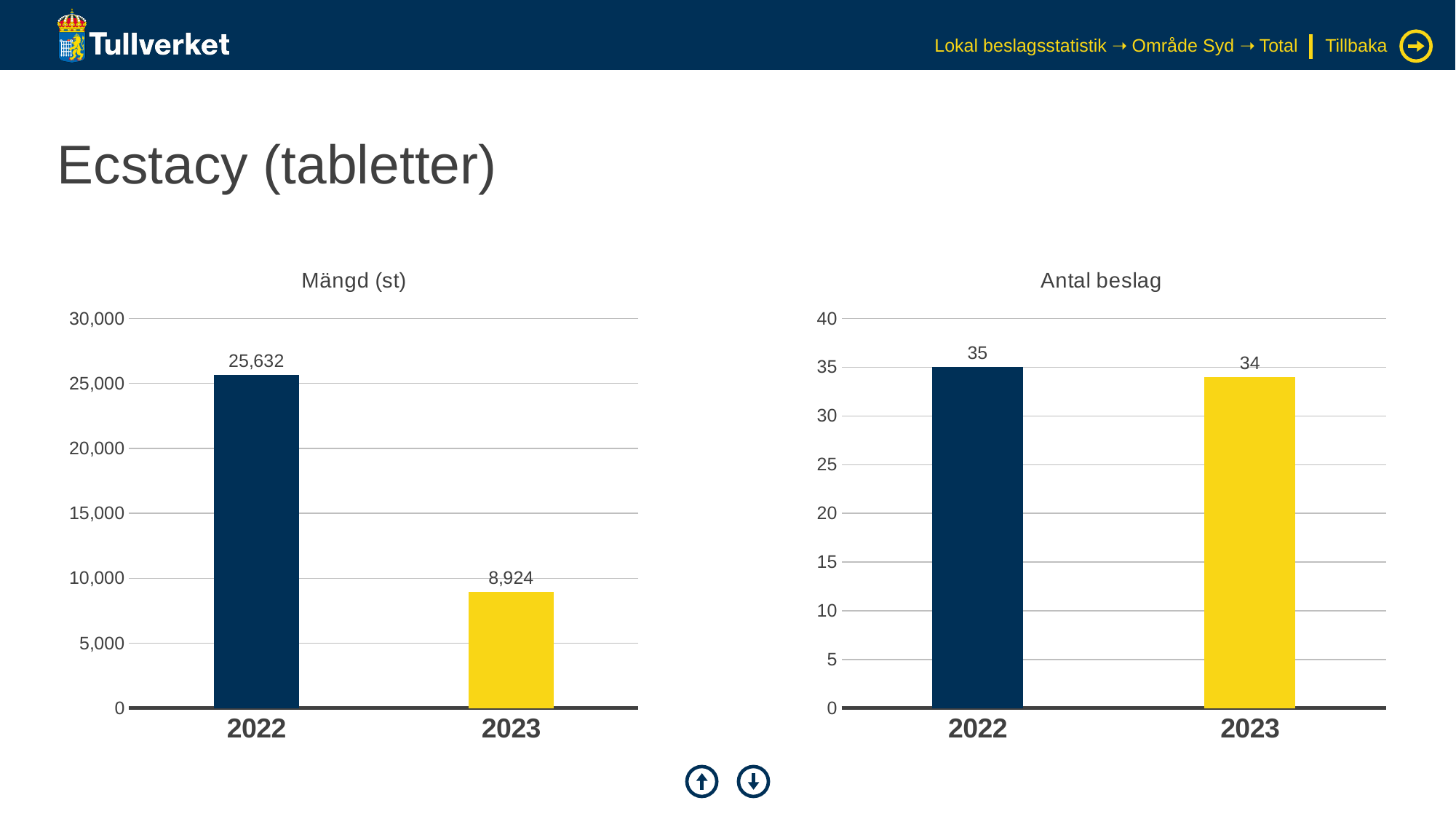
In the "Antal beslag" chart, what is the value for 2023? 34 In the "Mängd (st)" chart, what is the value for 2023? 8,924 In the "Mängd (st)" chart, what is the difference between the 2022 and 2023 values? 16,708 In the "Antal beslag" chart, what is the value for 2022? 35 In the "Mängd (st)" chart, which year has the highest value? 2022 In the "Mängd (st)" chart, which year has the lowest value? 2023 How many years are shown in the "Antal beslag" chart? 2 In the "Mängd (st)" chart, is the value for 2023 greater or less than 10,000? less What kind of chart is the "Mängd (st)" chart? bar chart In the "Mängd (st)" chart, what is the value for 2022? 25,632 In the "Antal beslag" chart, what is the difference between the 2022 and 2023 values? 1 In the "Mängd (st)" chart, do the values rise or fall from 2022 to 2023? fall